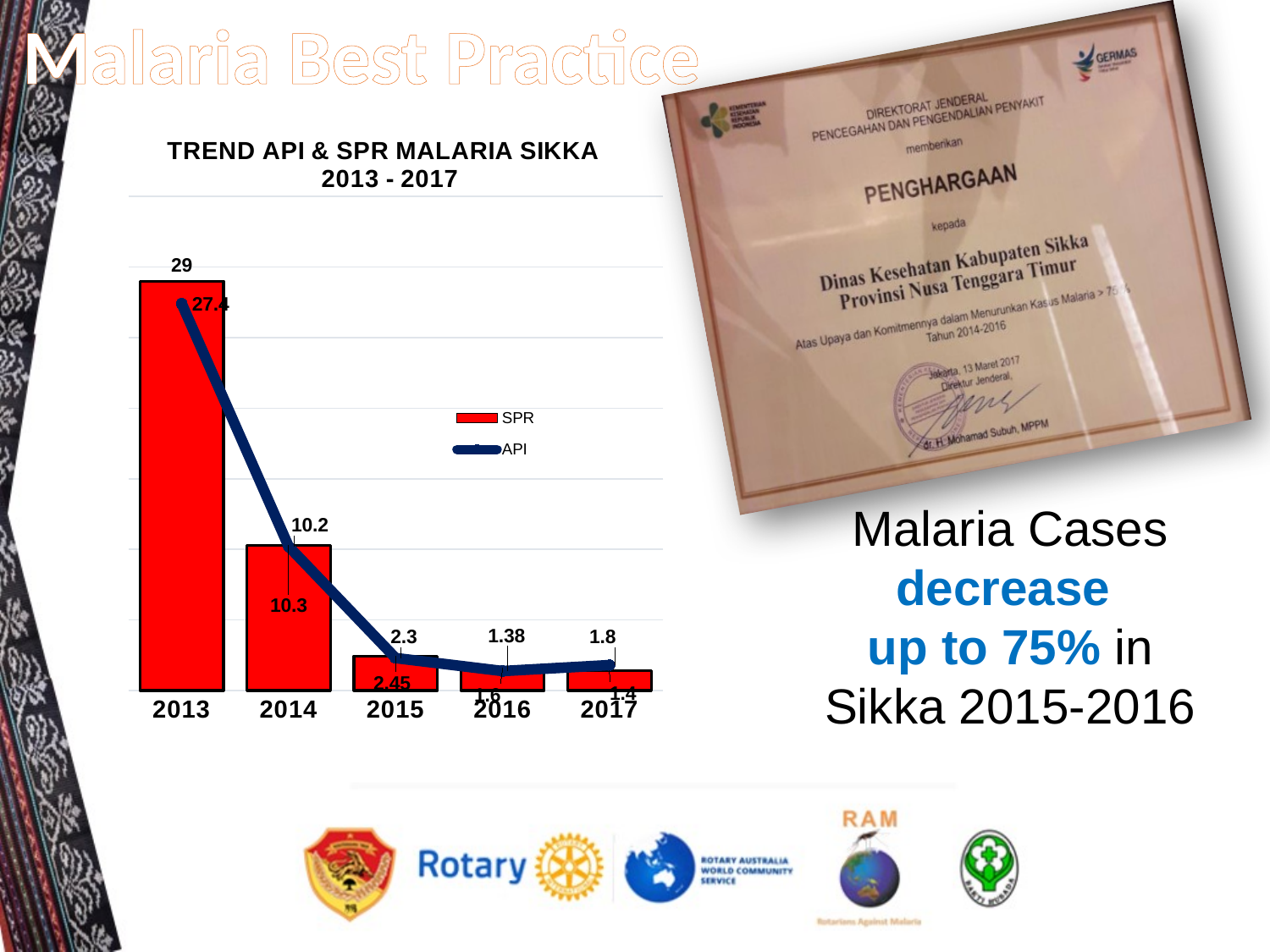
What is the SPR value for 2014? 10.3 What is the difference between the SPR values for 2013 and 2014? 18.7 What is the API value for 2014? 10.2 What is the SPR value for 2016? 1.6 How many years are shown on the x axis of the chart? 5 What is the SPR value for 2015? 2.45 What is the SPR value for 2013? 29 How many series does the chart legend list? 2 Which year has the lowest SPR value? 2017 What is the API value for 2013? 27.4 What type of chart is shown on the slide? Combined bar and line chart Which year has the highest SPR value? 2013